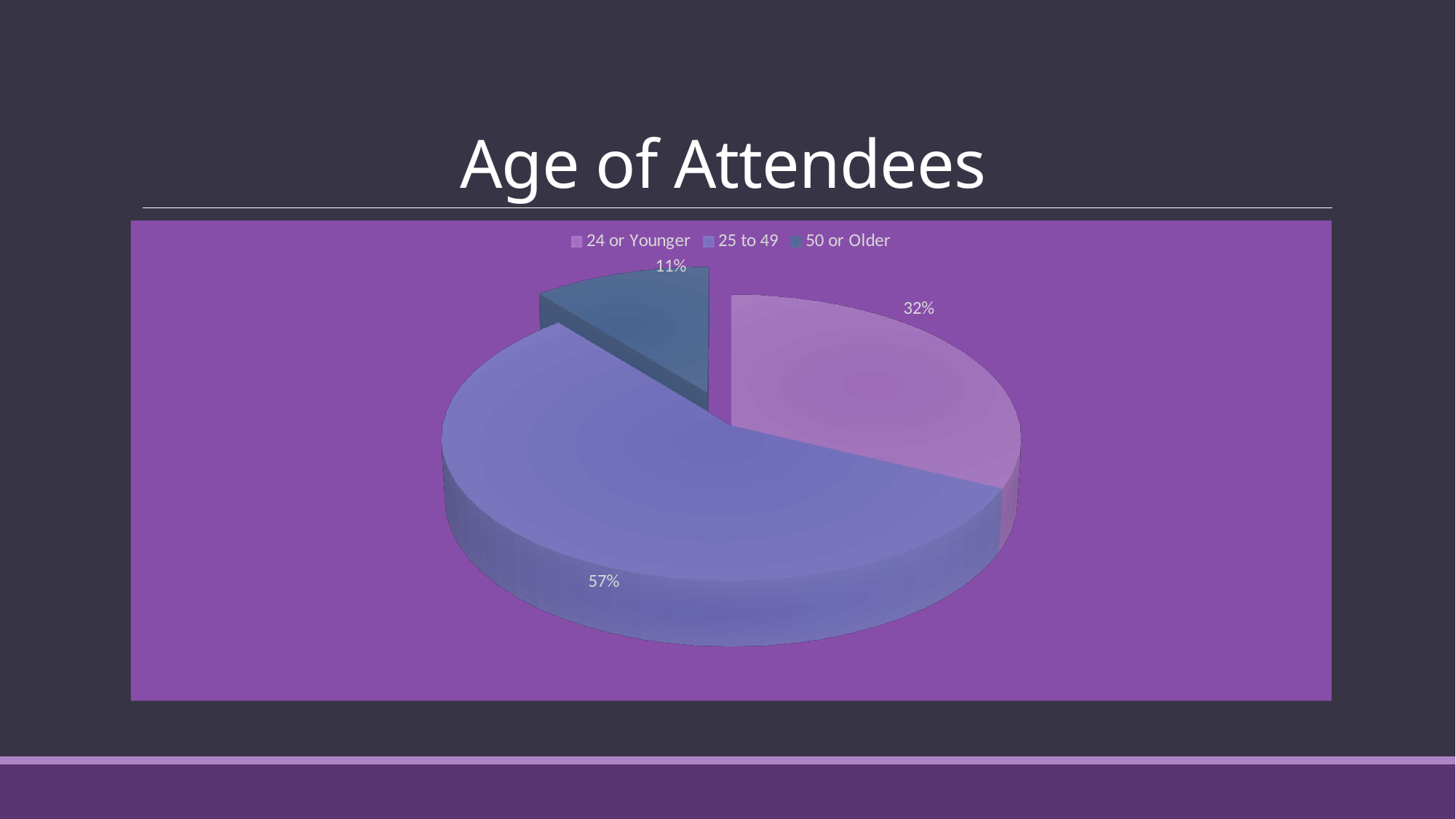
Which is larger, the share for 24 or Younger or the share for 50 or Older? 24 or Younger What kind of chart is shown on the slide? pie chart Which age group has the smallest share of attendees? 50 or Older How many percentage points larger is the 25 to 49 share than the 24 or Younger share? 25 How many percentage points larger is the 24 or Younger share than the 50 or Older share? 21 What share of attendees are 50 or Older? 11% How many age groups are shown in the pie chart? 3 Which slice is pulled out from the rest of the pie? 50 or Older What share of attendees are 24 or Younger? 32% What share of attendees are 25 to 49? 57% What is the title of the slide? Age of Attendees Which age group has the largest share of attendees? 25 to 49